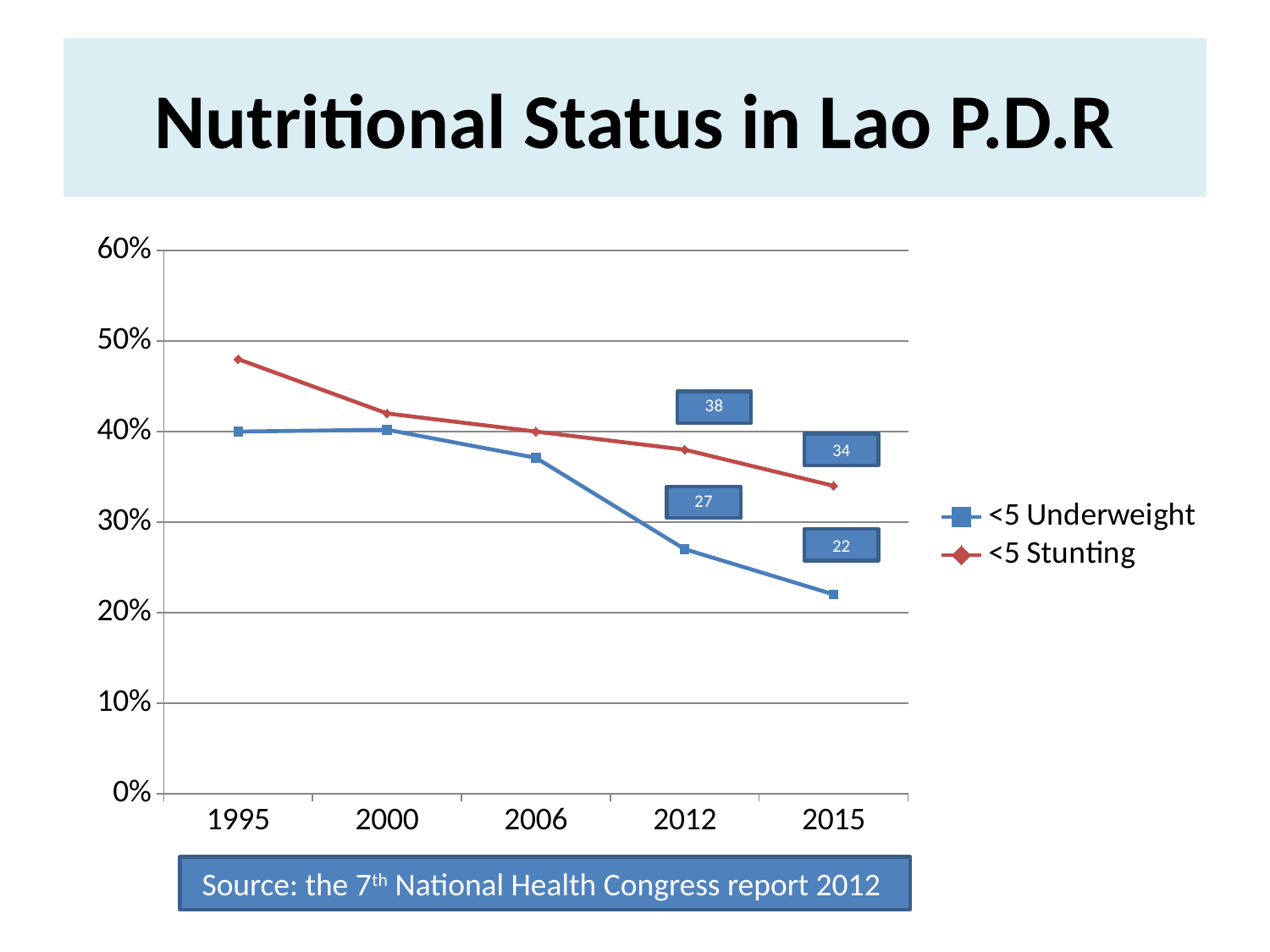
What kind of chart is shown on the slide? line chart What is the labelled value for <5 Stunting in 2012? 38 Is the value for <5 Stunting in 1995 greater or less than 40%? greater What is the labelled value for <5 Underweight in 2012? 27 Does the <5 Underweight line rise or fall from 2000 to 2015? fall How many series does the legend list? 2 How many years are shown on the x axis? 5 By how much did the labelled <5 Underweight value fall from 2012 to 2015? 5 By how much does the labelled <5 Stunting value exceed the labelled <5 Underweight value in 2012? 11 Which series has the higher value in 2015, <5 Underweight or <5 Stunting? <5 Stunting What is the labelled value for <5 Underweight in 2015? 22 What is the labelled value for <5 Stunting in 2015? 34